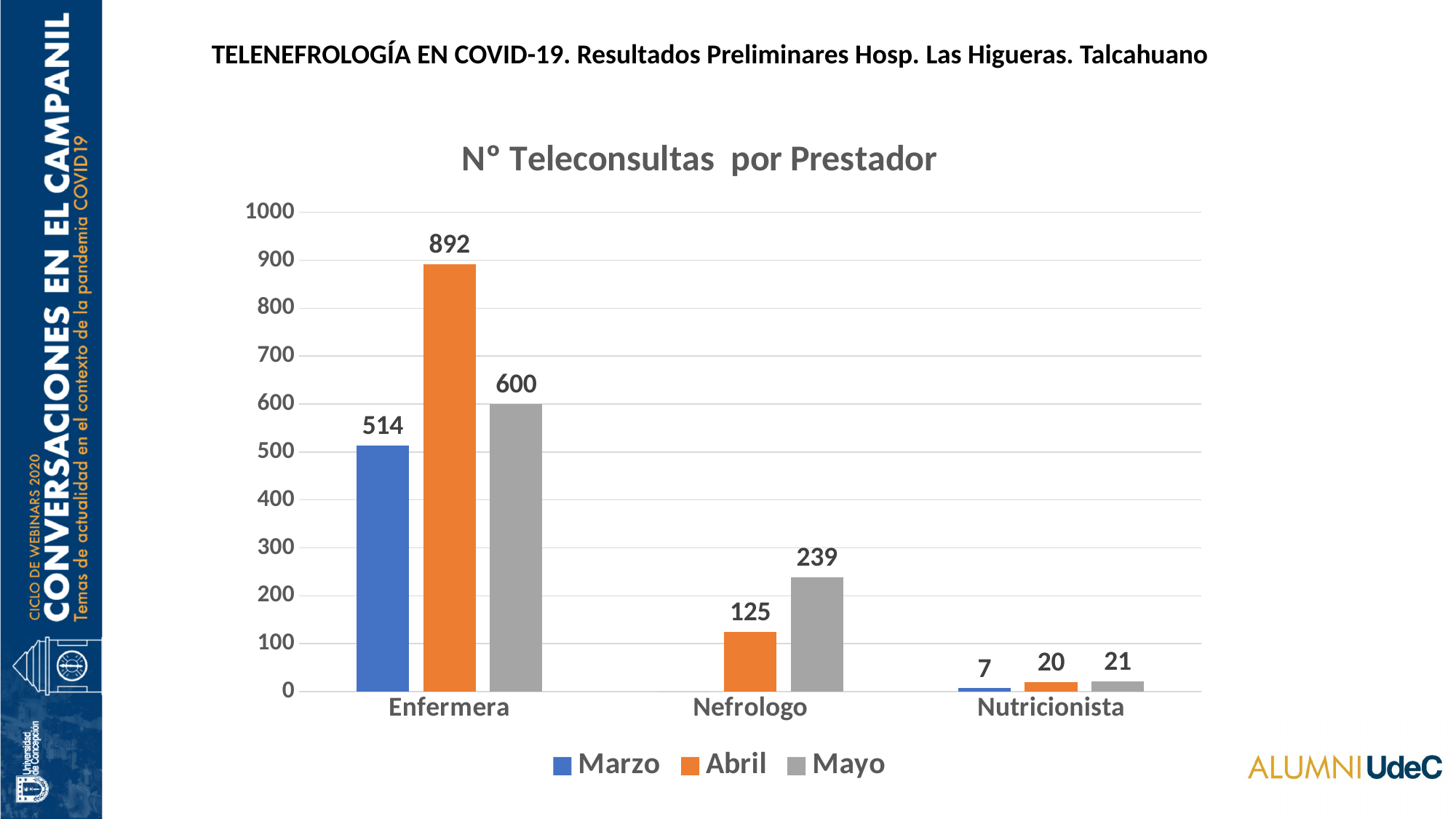
Which category has the lowest value in the Abril series? Nutricionista What is the value for Nutricionista in Marzo? 7 What kind of chart is shown? Bar chart What is the value for Nefrologo in Mayo? 239 Which is larger: the Mayo value for Nefrologo or the Abril value for Nefrologo? Mayo value for Nefrologo How many categories are shown on the x axis? 3 What is the value for Enfermera in Abril? 892 How many series does the legend list? 3 Does the value for Nutricionista rise or fall from Marzo to Mayo? Rise What is the title of the chart? N° Teleconsultas por Prestador Which category has the highest value in the Mayo series? Enfermera What is the difference between the Abril and Marzo values for Enfermera? 378